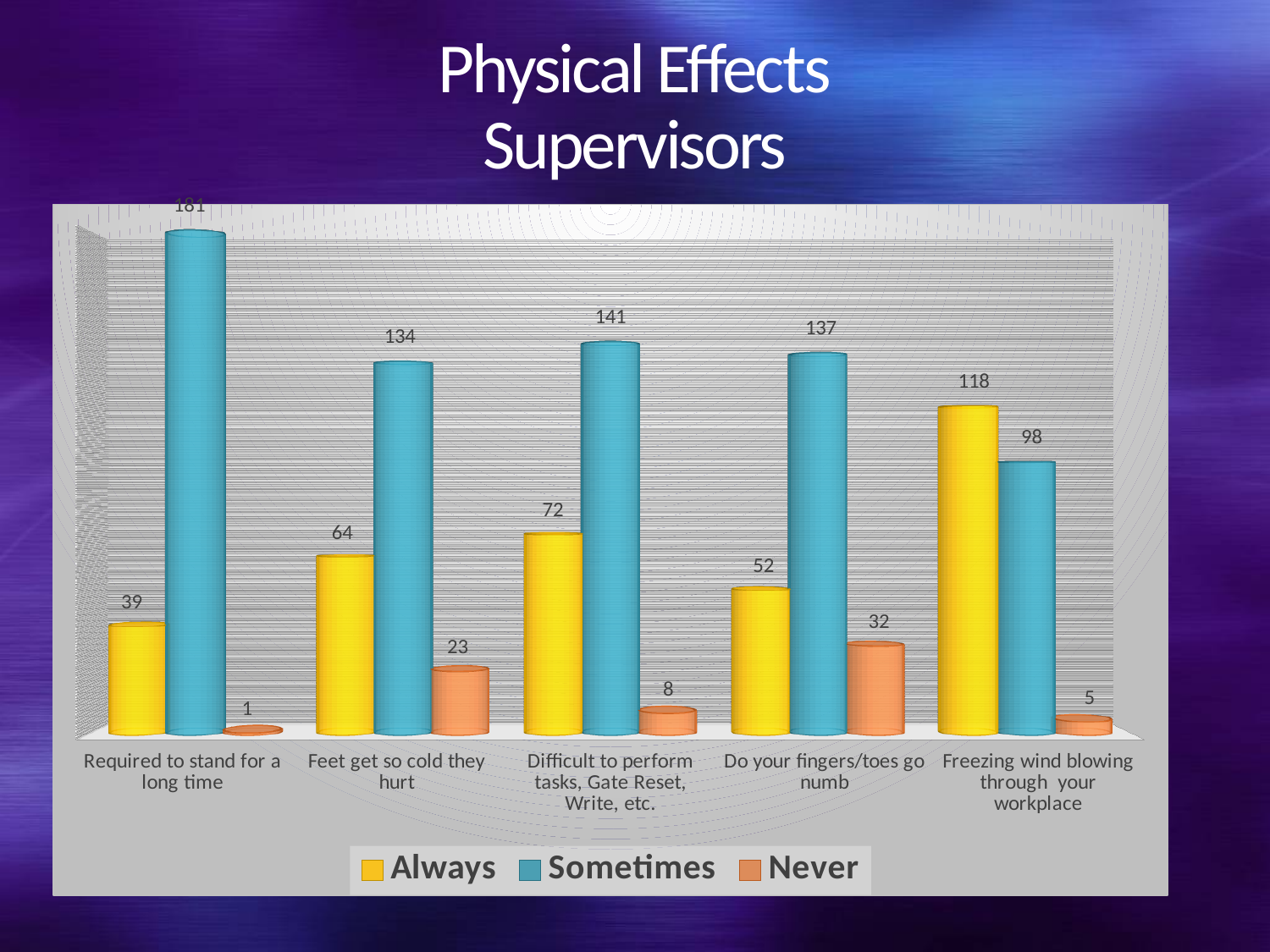
How many categories are shown on the x axis? 5 What kind of chart is shown on the slide? Bar chart What is the 'Never' value for 'Do your fingers/toes go numb'? 32 What is the 'Always' value for 'Freezing wind blowing through your workplace'? 118 What is the 'Sometimes' value for 'Feet get so cold they hurt'? 134 Which colour represents the 'Never' series in the legend? Orange Which category has the highest 'Sometimes' value? Required to stand for a long time Which category has the lowest 'Never' value? Required to stand for a long time What is the total of the 'Always', 'Sometimes' and 'Never' values for 'Feet get so cold they hurt'? 221 How many series does the legend list? 3 For 'Freezing wind blowing through your workplace', which is larger: the 'Always' value or the 'Sometimes' value? Always What is the difference between the 'Sometimes' and 'Always' values for 'Difficult to perform tasks, Gate Reset, Write, etc.'? 69